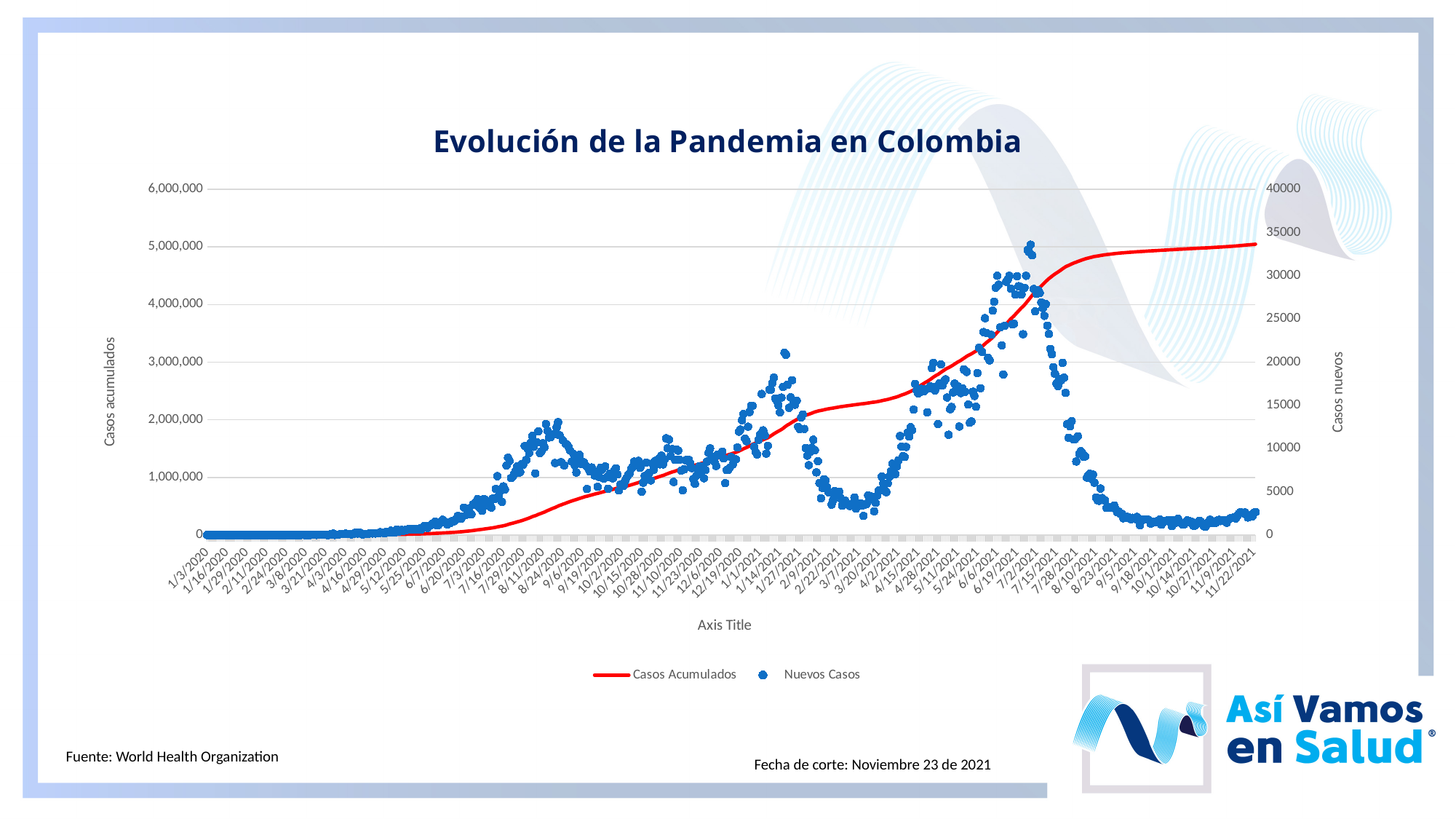
What is the title of the chart? Evolución de la Pandemia en Colombia Does the Casos Acumulados series rise or fall along the x axis? rise Which series is drawn as a red line? Casos Acumulados Is the highest value of Nuevos Casos greater or less than 30000? greater What kind of chart is shown on the slide? A combined line and scatter chart Is the value of Nuevos Casos at 8/24/2020 greater or less than 15000? less Which is larger: the Casos Acumulados value at 11/22/2021 or at 1/1/2021? 11/22/2021 Is the value of Casos Acumulados at 1/1/2021 greater or less than 1,000,000? greater How many series does the legend list? 2 In which year does the Nuevos Casos series reach its highest value? 2021